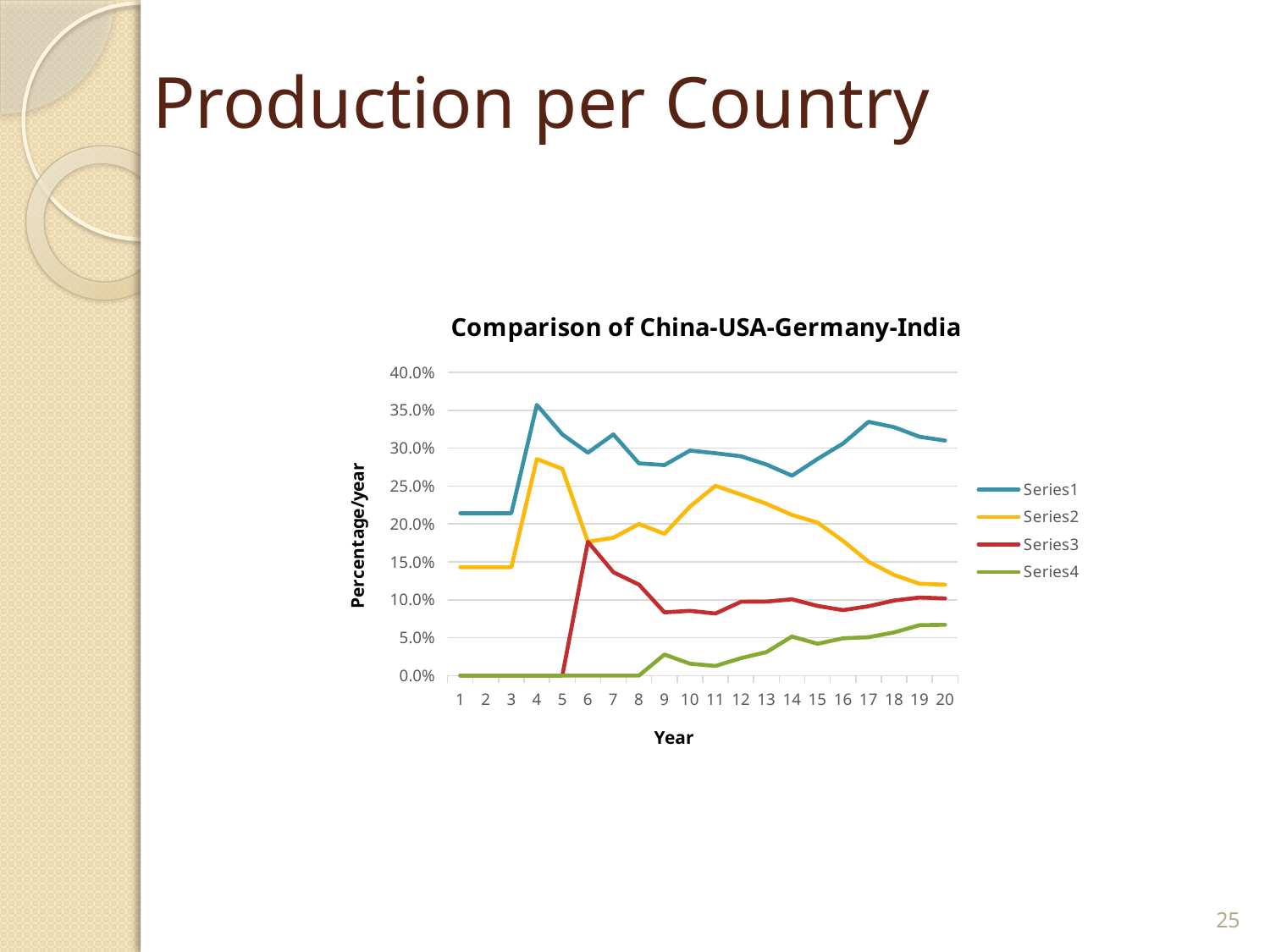
What kind of chart is shown on the slide? line chart Is the value for Series2 in year 20 greater or less than 15.0%? less What is the value of Series3 in year 3? 0.0% How many series does the legend list? 4 Which series has the highest value in year 20? Series1 Does Series2 rise or fall from year 11 to year 20? fall Is the value for Series1 in year 4 greater or less than 30.0%? greater How many years are plotted along the x axis? 20 What is the label of the vertical axis? Percentage/year What is the value of Series4 in year 1? 0.0% What is the title of the chart? Comparison of China-USA-Germany-India Which series has the lowest value in year 20? Series4